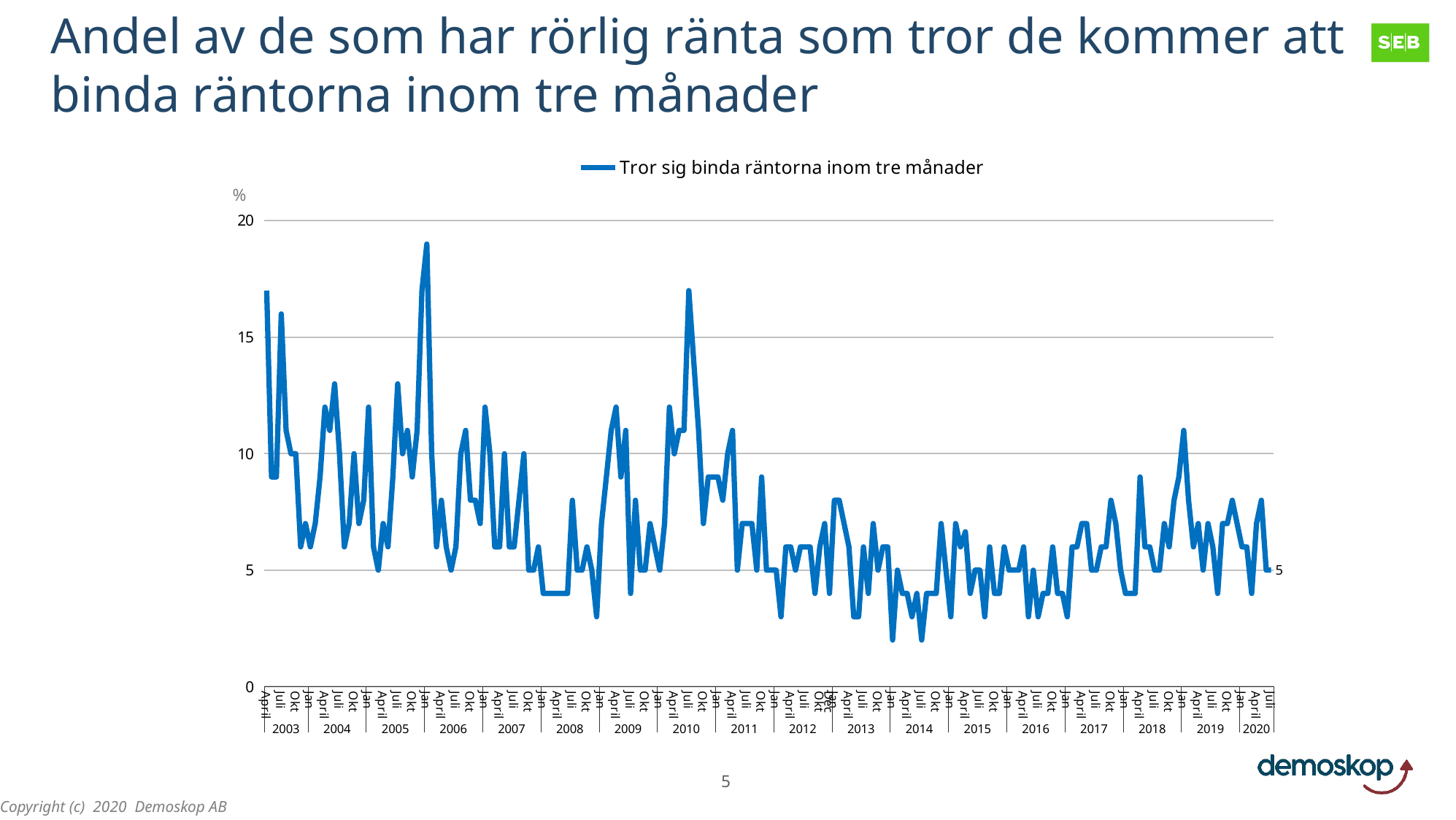
Is the highest value reached in 2006 greater or less than 15? greater What is the legend entry for the plotted series? Tror sig binda räntorna inom tre månader How many series does the legend list? 1 How many years are labelled on the x axis? 18 In which year does the line reach its lowest point? 2014 What is the value of the last data point (Juli 2020), as printed on the chart? 5 Is the value at the start of the series in April 2003 greater or less than 15? greater Is the value in Jan 2014 greater or less than 5? less Which is higher, the peak in 2006 or the peak in 2010? 2006 What kind of chart is shown on the slide? line chart Overall, do the values rise or fall from 2003 to 2020? fall In which year does the line reach its highest point? 2006